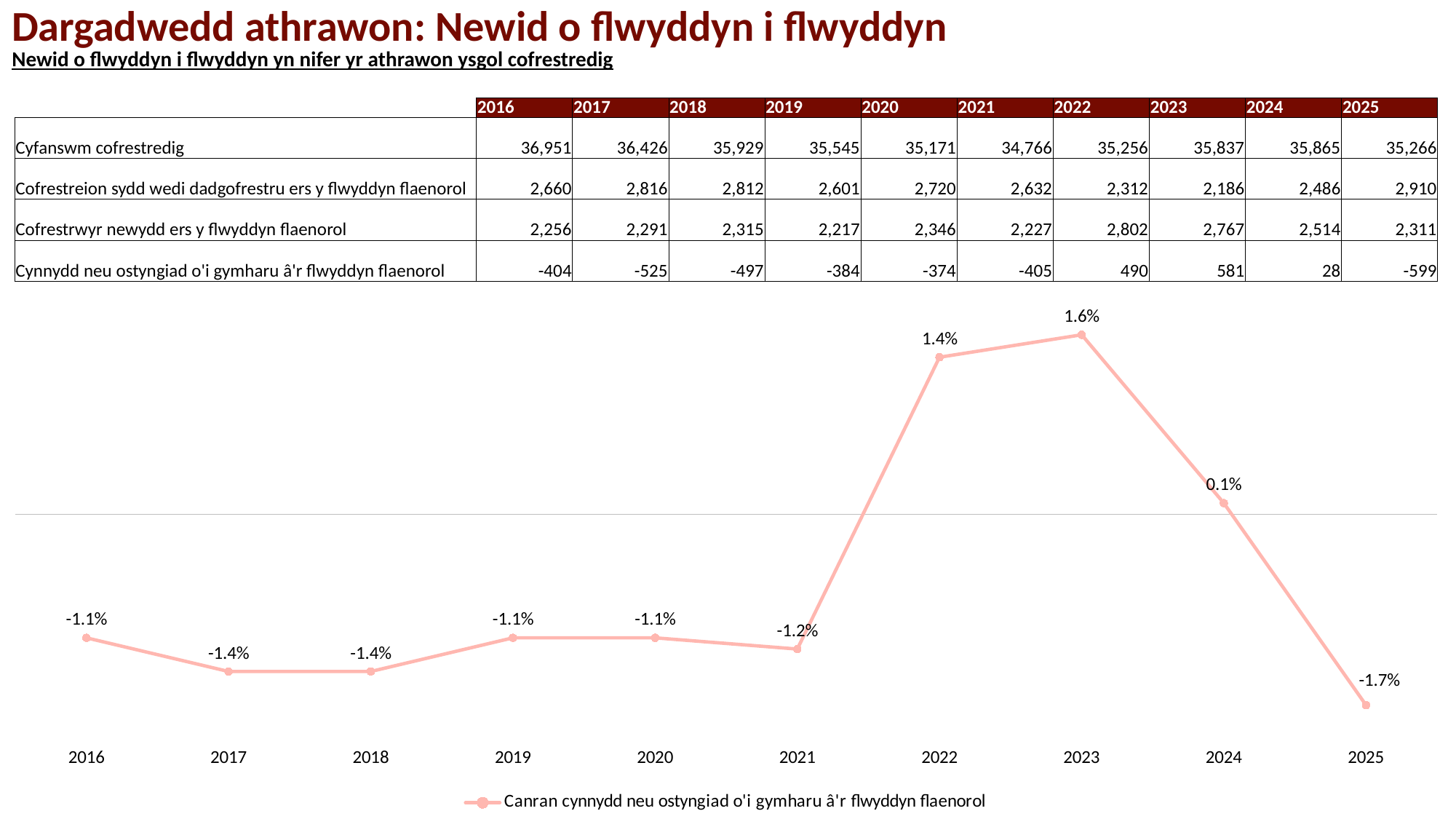
What is the percentage change value plotted for 2024? 0.1% Does the plotted line rise or fall from 2023 to 2025? fall How many series does the chart legend list? 1 What is the percentage change value plotted for 2023? 1.6% What is the difference between the plotted values for 2023 and 2022? 0.2% Is the plotted value for 2022 larger or smaller than the value for 2021? larger What is the percentage change value plotted for 2016? -1.1% What is the percentage change value plotted for 2025? -1.7% Which year has the lowest plotted percentage change? 2025 What type of chart is shown on the slide? line chart How many years are plotted on the x axis of the chart? 10 Which year has the highest plotted percentage change? 2023